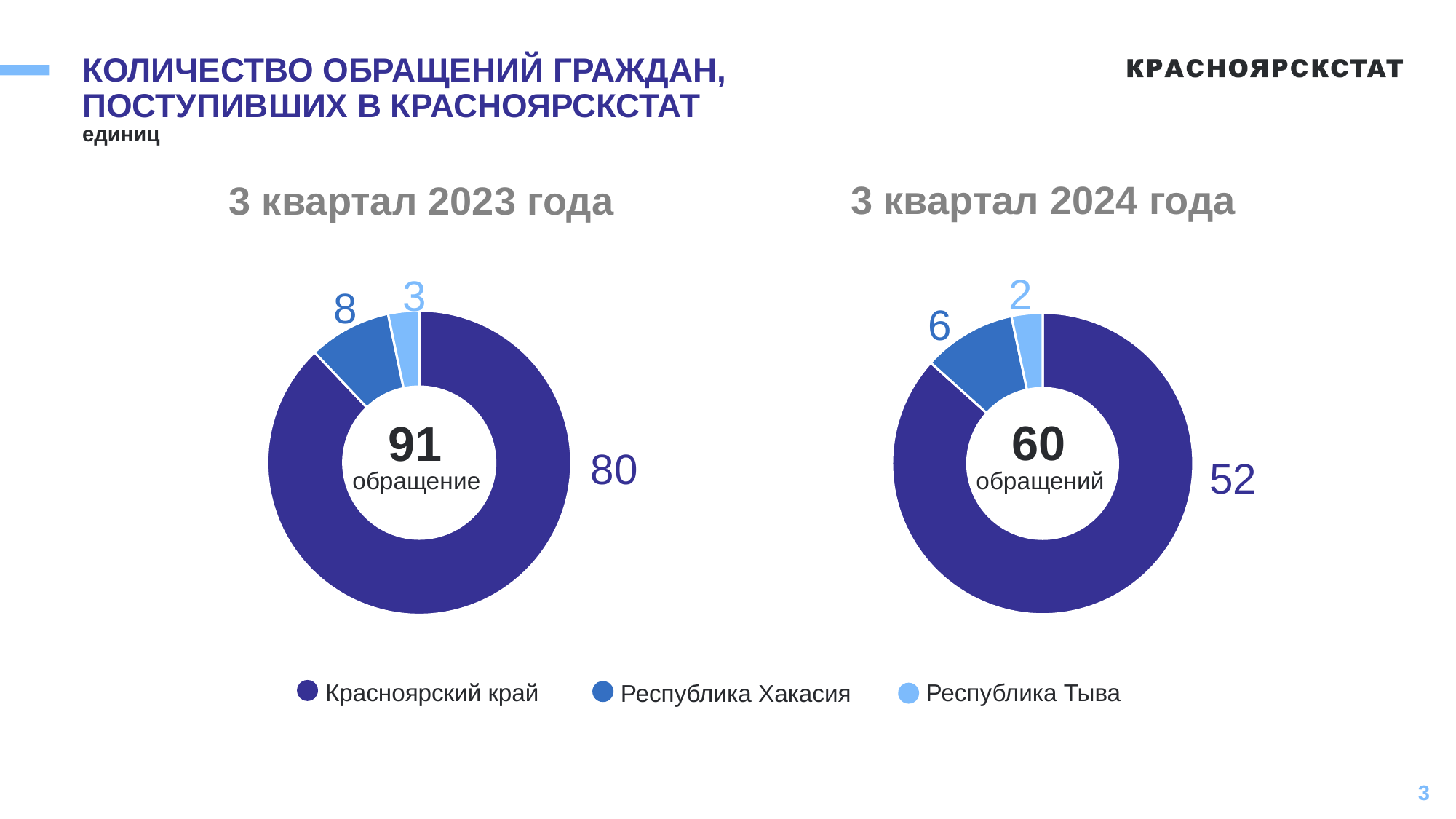
Какое общее число обращений показано в центре диаграммы «3 квартал 2024 года»? 60 На диаграмме «3 квартал 2024 года» сколько обращений поступило из Республики Хакасия? 6 Какого типа диаграммы представлены на слайде? Кольцевые (круговые) диаграммы На диаграмме «3 квартал 2023 года» сколько обращений поступило из Красноярского края? 80 Сколько регионов (категорий) показано на диаграмме «3 квартал 2023 года»? 3 Каким цветом на легенде обозначена Республика Тыва? Светло-голубым На сколько обращений из Красноярского края в 3 квартале 2023 года больше, чем в 3 квартале 2024 года? 28 На диаграмме «3 квартал 2023 года» на сколько обращений из Республики Хакасия больше, чем из Республики Тыва? 5 Где больше обращений из Республики Хакасия: в 3 квартале 2023 года или в 3 квартале 2024 года? 3 квартал 2023 года На диаграмме «3 квартал 2024 года» сколько обращений поступило из Республики Тыва? 2 На диаграмме «3 квартал 2024 года» какой регион имеет наибольшее число обращений? Красноярский край На диаграмме «3 квартал 2023 года» какой регион имеет наименьшее число обращений? Республика Тыва